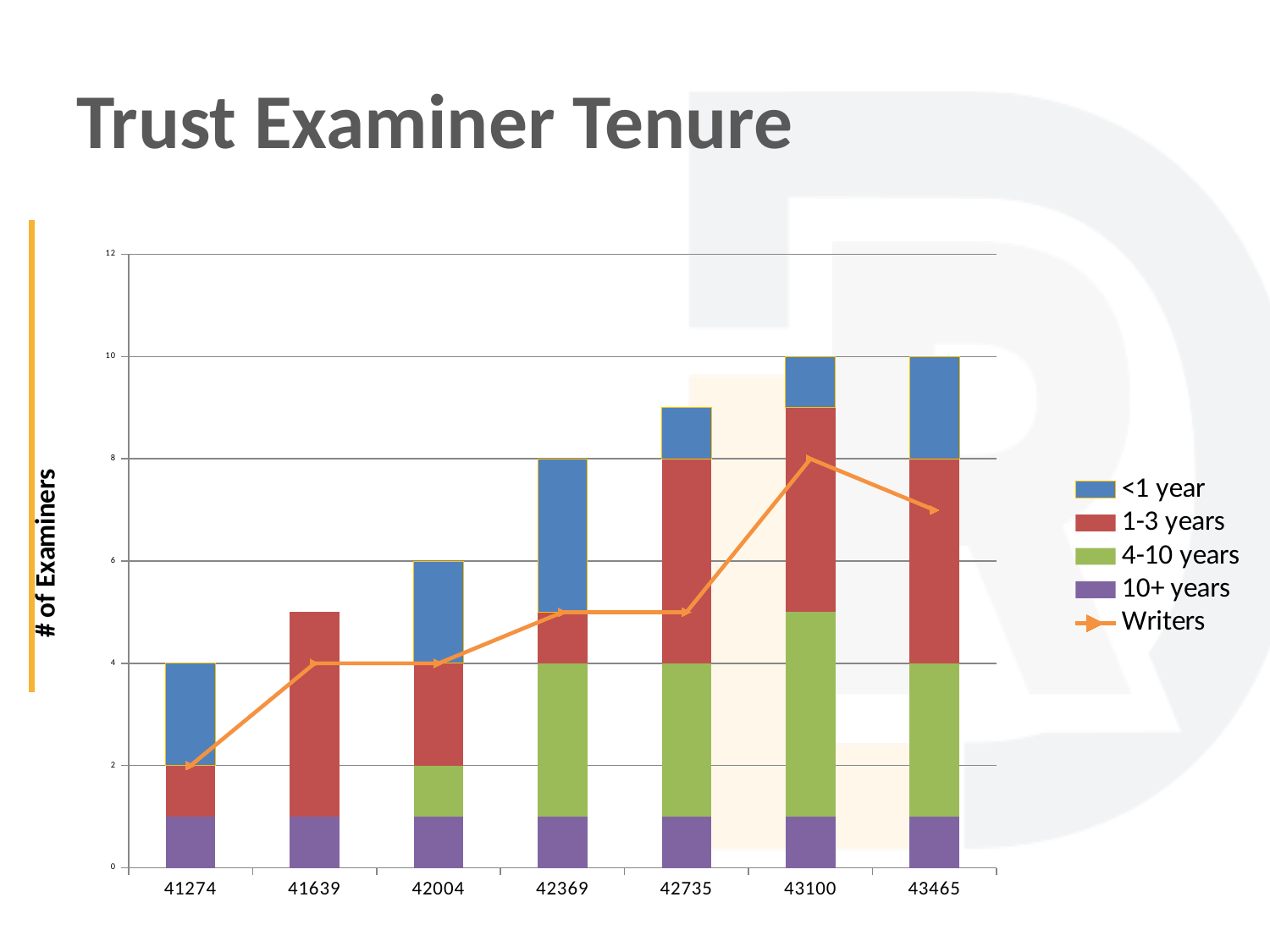
How many categories are shown along the x axis? 7 Is the Writers value for 43465 greater or less than 6? greater Is the total height of the stacked bar for 41639 greater or less than 6? less What is the total height of the stacked bar for 43100? 10 Which category has the lowest total stacked bar? 41274 What is the Writers value for 43100? 8 How many series does the legend list? 5 What is the Writers value for 41274? 2 What is the y-axis title of the chart? # of Examiners What kind of chart is shown on the slide? stacked bar chart with a line Which category has the highest Writers value? 43100 What is the total height of the stacked bar for 41274? 4